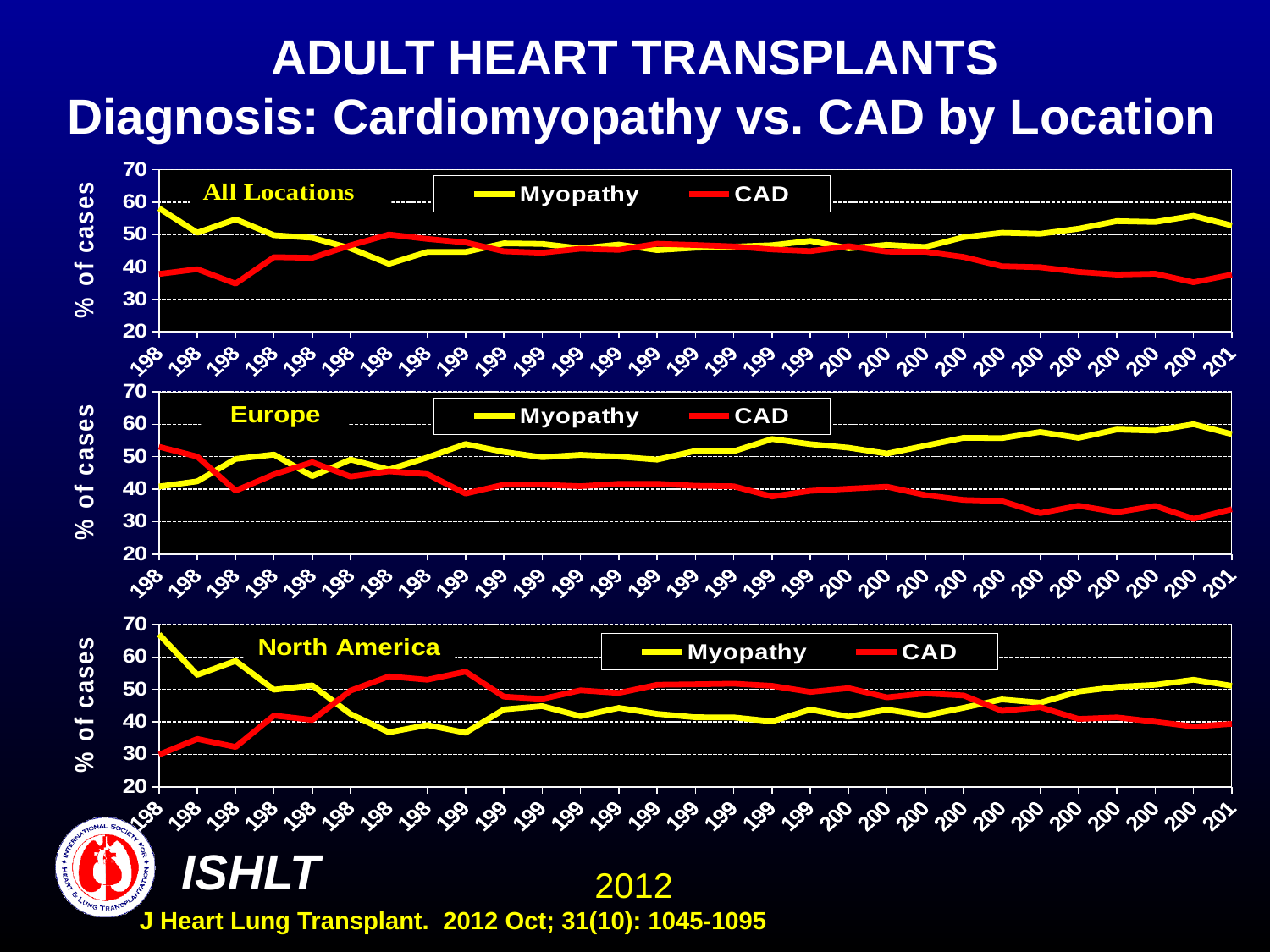
In the All Locations chart, is the Myopathy value at the leftmost point greater or less than 50? greater What is the label on the vertical axis of the Europe chart? % of cases In the Europe chart, does the Myopathy line rise or fall overall from left to right? rise In the Europe chart, is the CAD value at the rightmost point greater or less than 40? less What kind of chart is used for the All Locations panel? line chart How many series does the legend of the Europe chart list? 2 How many charts are shown on the slide? 3 In the Europe chart, does the CAD line rise or fall overall from left to right? fall In the North America chart, does the Myopathy line rise or fall overall from left to right? fall In the North America chart, is the Myopathy value at the leftmost point greater or less than 60? greater In the Europe chart, at the rightmost point, which series is larger, Myopathy or CAD? Myopathy In the North America chart, which series is shown in red? CAD